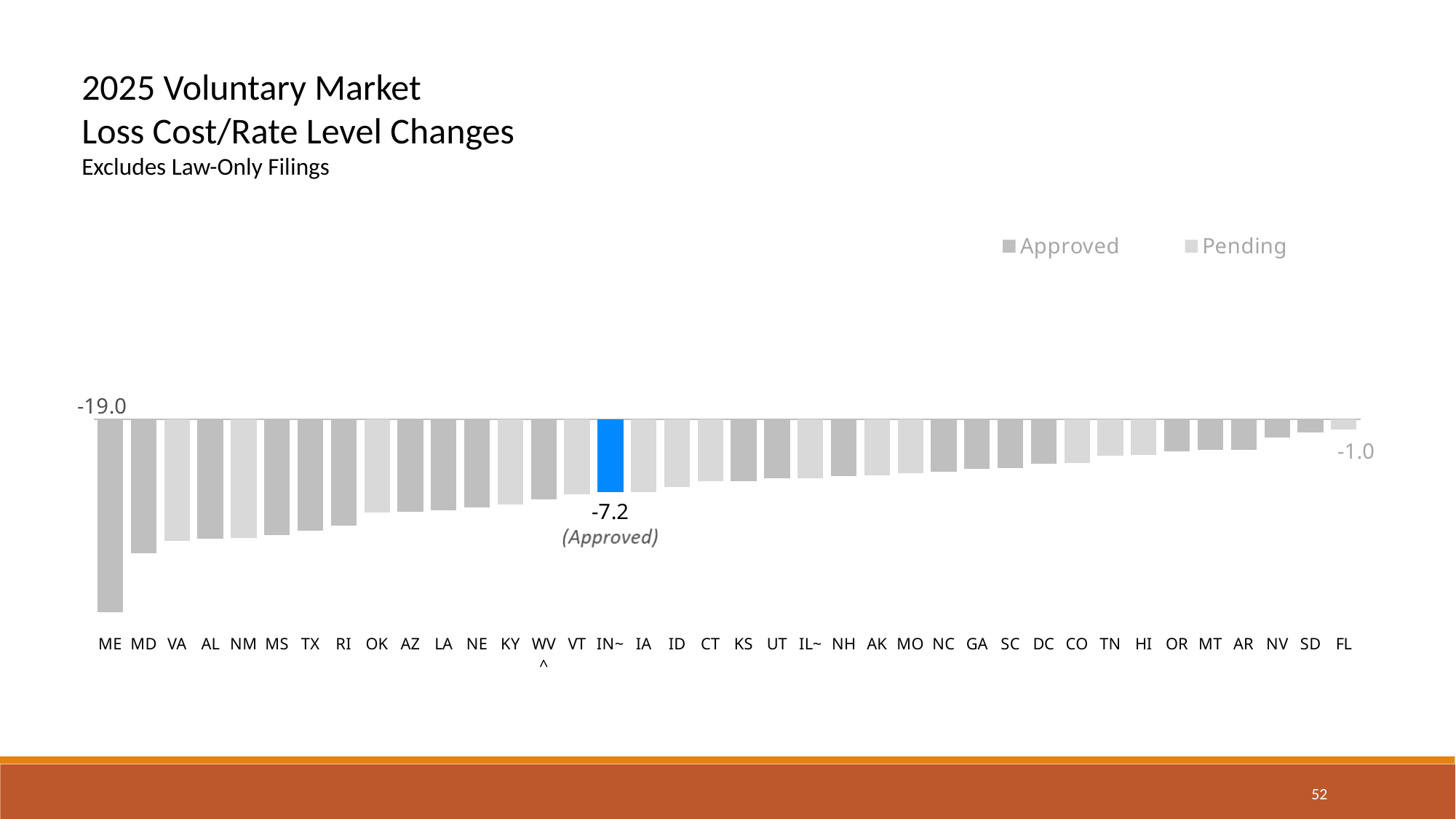
How many series does the legend list? 2 What kind of chart is shown on the slide? Bar chart Which has the larger decrease, ME or MD? ME Which state has the smallest decrease (highest value) on the chart? FL Which state has the largest decrease (lowest value) on the chart? ME What is the difference between the values for ME and IN~? 11.8 What is the value shown for FL? -1.0 Do the values rise or fall moving from left to right along the x axis? Rise What is the value shown for ME? -19.0 How many states are shown on the x axis? 38 What is the value shown for IN~? -7.2 What is the difference between the values for ME and FL? 18.0